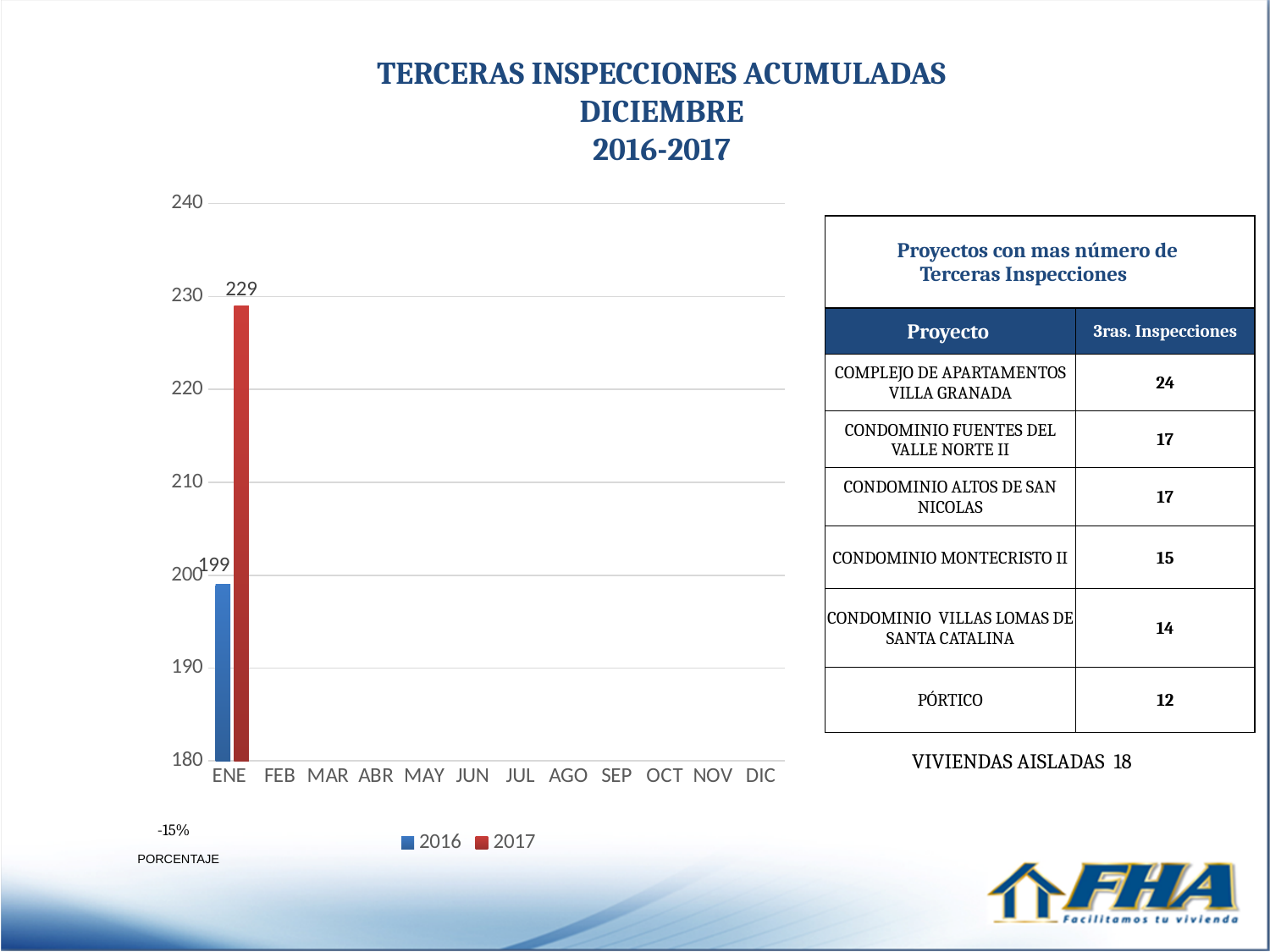
What is the value for 2016 in ENE? 199 What is the value for 2017 in ENE? 229 How many series does the legend list? 2 What kind of chart is shown on the slide? bar chart What is the highest value shown on the y axis? 240 Which month is the only one with plotted bars? ENE What is the difference between the 2017 and 2016 values in ENE? 30 How many month categories are shown on the x axis? 12 Is the value for 2017 in ENE greater or less than 220? greater Is the value for 2016 in ENE greater or less than 200? less What colour represents the 2017 series in the legend? red Which series has the higher value in ENE, 2016 or 2017? 2017